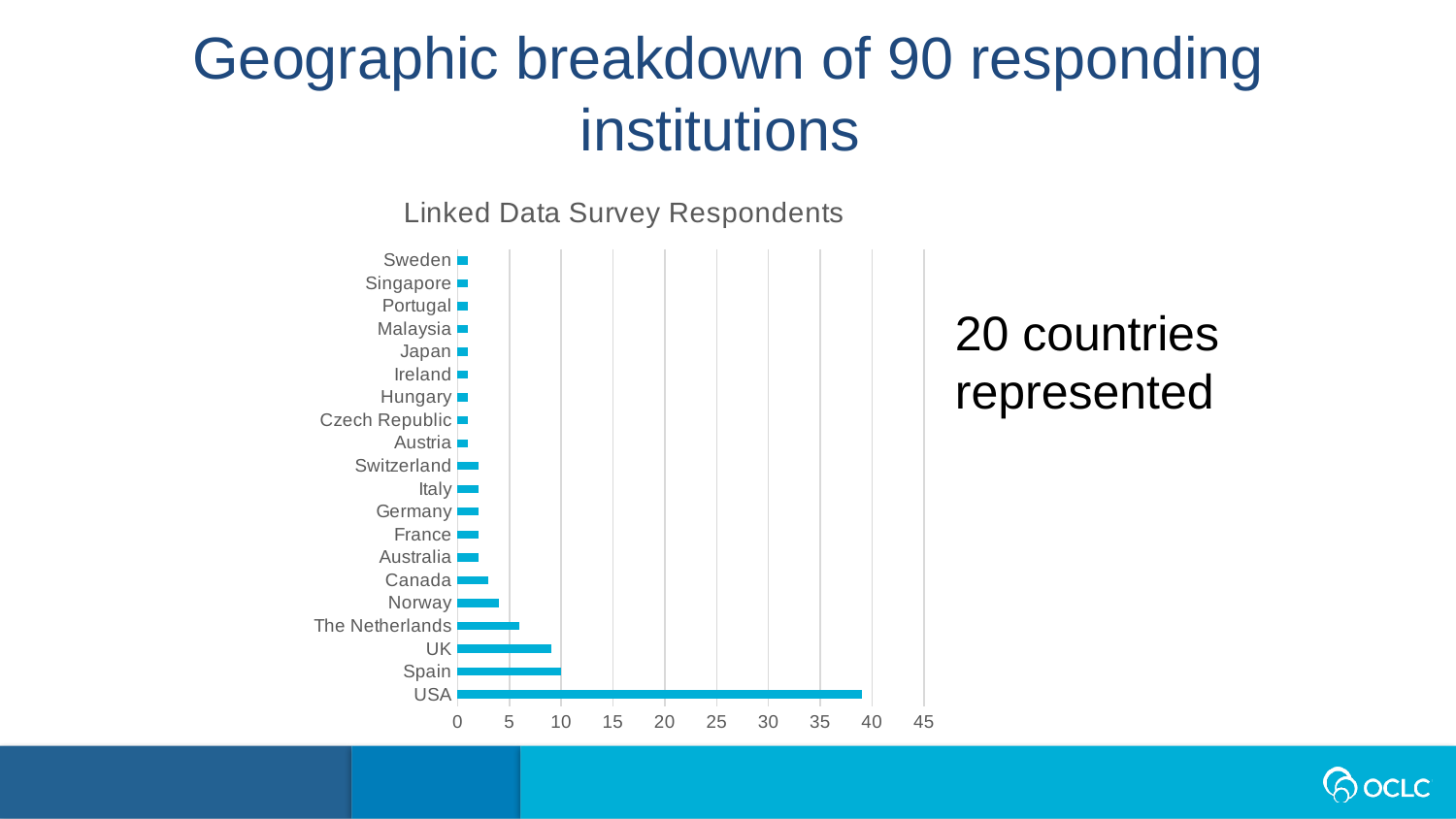
Which has more respondents, Spain or UK? Spain Is the value for The Netherlands greater or less than 5? greater Which has more respondents, Canada or Australia? Canada What is the title of the chart? Linked Data Survey Respondents What is the value for Spain? 10 Is the value for UK greater or less than 10? less What kind of chart is shown on the slide? bar chart Is the value for Norway greater or less than 5? less Which has more respondents, The Netherlands or Norway? The Netherlands How many countries are listed in the chart? 20 Which country has the highest number of respondents in the chart? USA